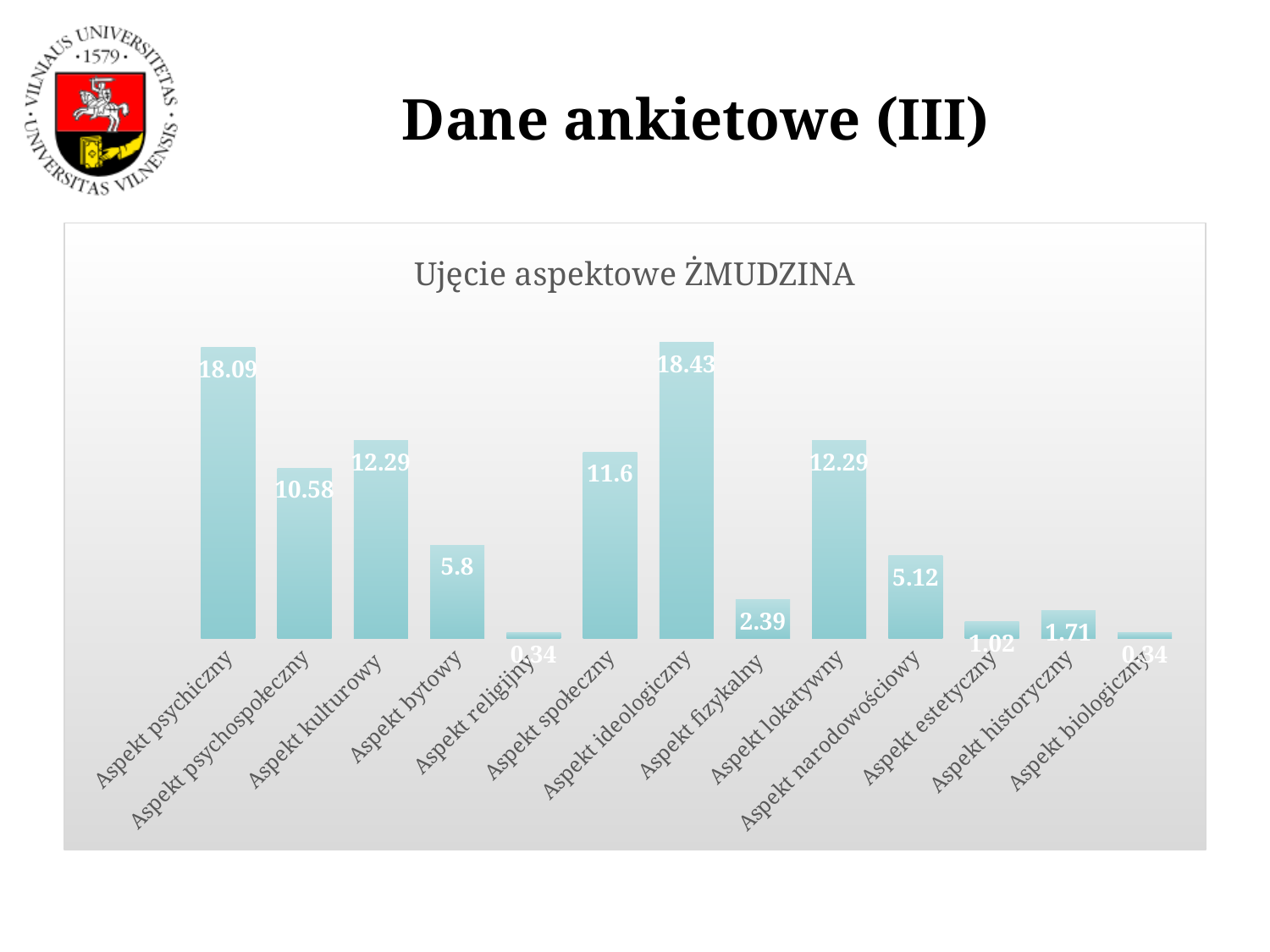
What is the title of the chart? Ujęcie aspektowe ŻMUDZINA What is the value for Aspekt psychiczny? 18.09 Which is larger, the value for Aspekt historyczny or the value for Aspekt estetyczny? Aspekt historyczny What is the value for Aspekt narodowościowy? 5.12 What is the difference between the values for Aspekt kulturowy and Aspekt psychospołeczny? 1.71 Which category has the highest value? Aspekt ideologiczny What is the value for Aspekt fizykalny? 2.39 How many categories are shown in the chart? 13 What is the value for Aspekt bytowy? 5.8 What is the difference between the values for Aspekt ideologiczny and Aspekt psychiczny? 0.34 What kind of chart is shown on the slide? Bar chart Which is larger, the value for Aspekt społeczny or the value for Aspekt psychospołeczny? Aspekt społeczny